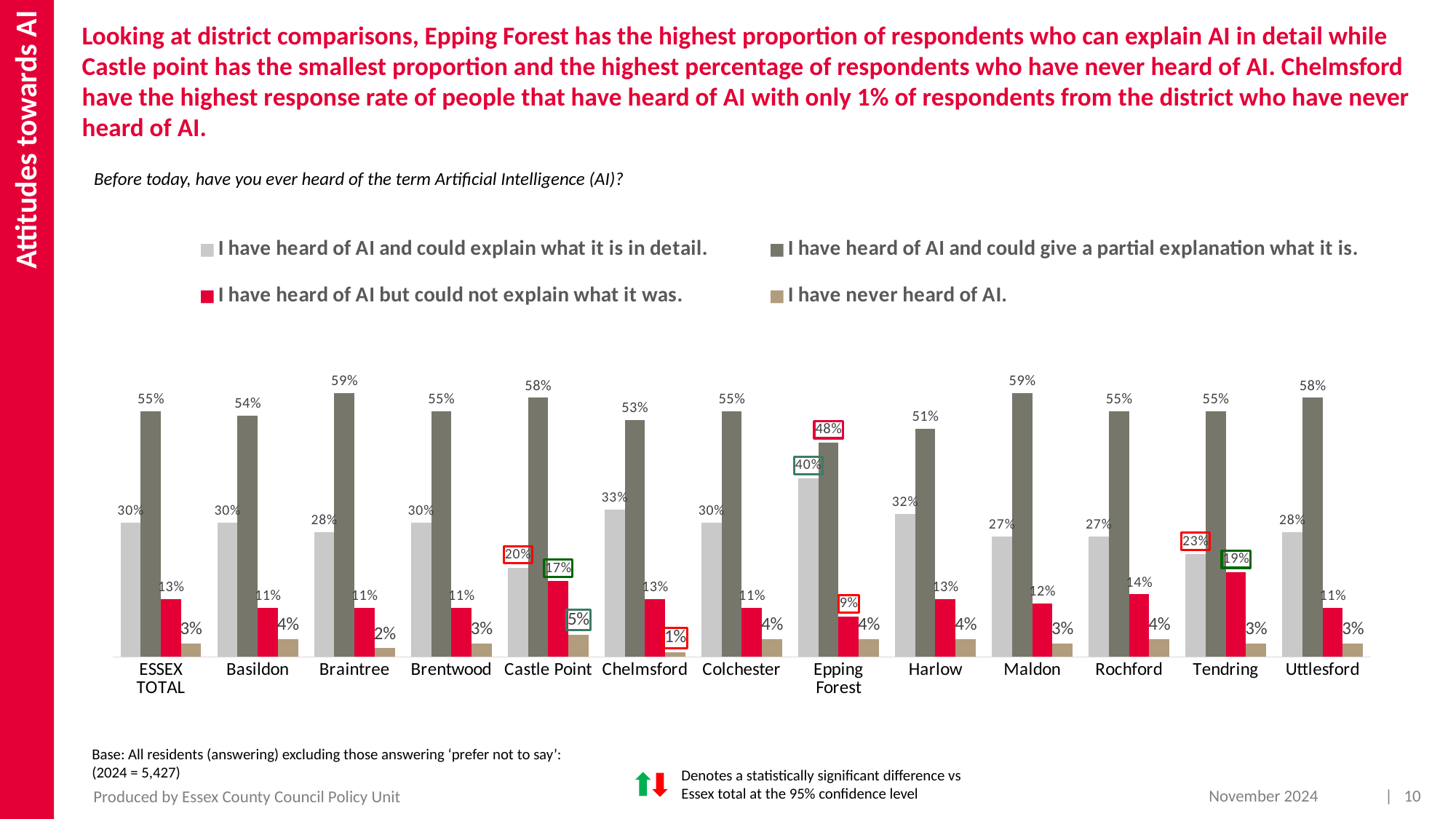
Which district has the highest percentage of respondents who have never heard of AI? Castle Point What percentage of Chelmsford respondents said they have never heard of AI? 1% How many districts (including the Essex total) are shown on the x axis? 13 How many series does the legend list? 4 What is the value for Tendring in the 'I have heard of AI but could not explain what it was' series? 19% Which district has the lowest proportion of respondents who have heard of AI and could explain it in detail? Castle Point What is the difference between Epping Forest's and the Essex total's percentage of respondents who could explain AI in detail? 10% Which is larger: the 'could not explain' percentage for Castle Point or for Chelmsford? Castle Point Which district has the lowest value for 'I have heard of AI and could give a partial explanation what it is'? Epping Forest What percentage of Epping Forest respondents said they have heard of AI and could explain what it is in detail? 40% What type of chart is shown on the slide? Bar chart Which district has the highest proportion of respondents who have heard of AI and could explain it in detail? Epping Forest